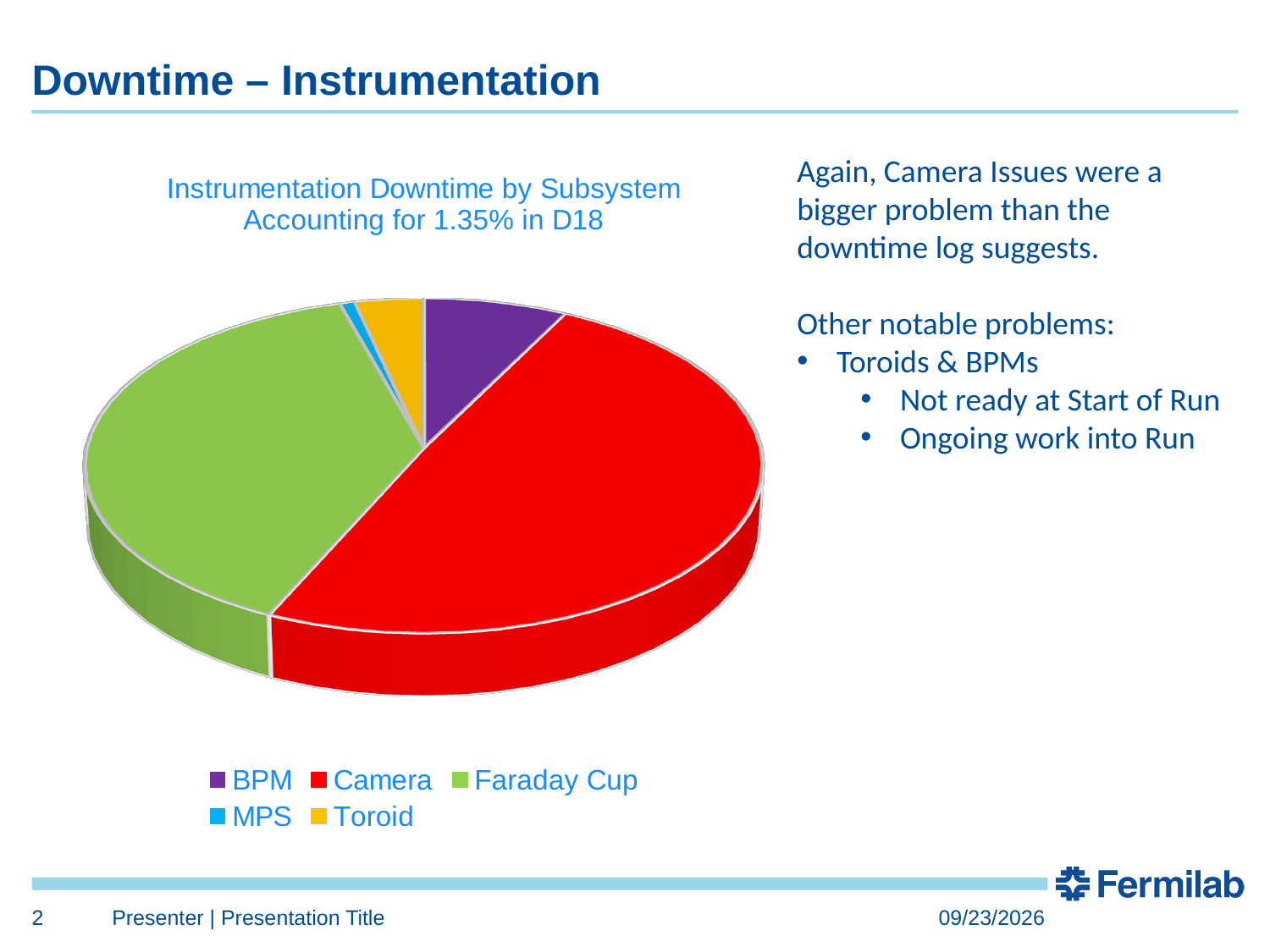
Which has the larger slice, Camera or Faraday Cup? Camera How many subsystems (slices) does the pie chart show? 5 Which has the larger slice, BPM or MPS? BPM What colour is the Faraday Cup slice in the pie chart? green What is the title of the chart? Instrumentation Downtime by Subsystem Accounting for 1.35% in D18 Which subsystem accounts for the largest share of instrumentation downtime? Camera What kind of chart is shown on the slide? pie chart Which has the larger slice, Faraday Cup or BPM? Faraday Cup Which subsystem accounts for the smallest share of instrumentation downtime? MPS Which subsystem has the second-largest slice in the pie chart? Faraday Cup